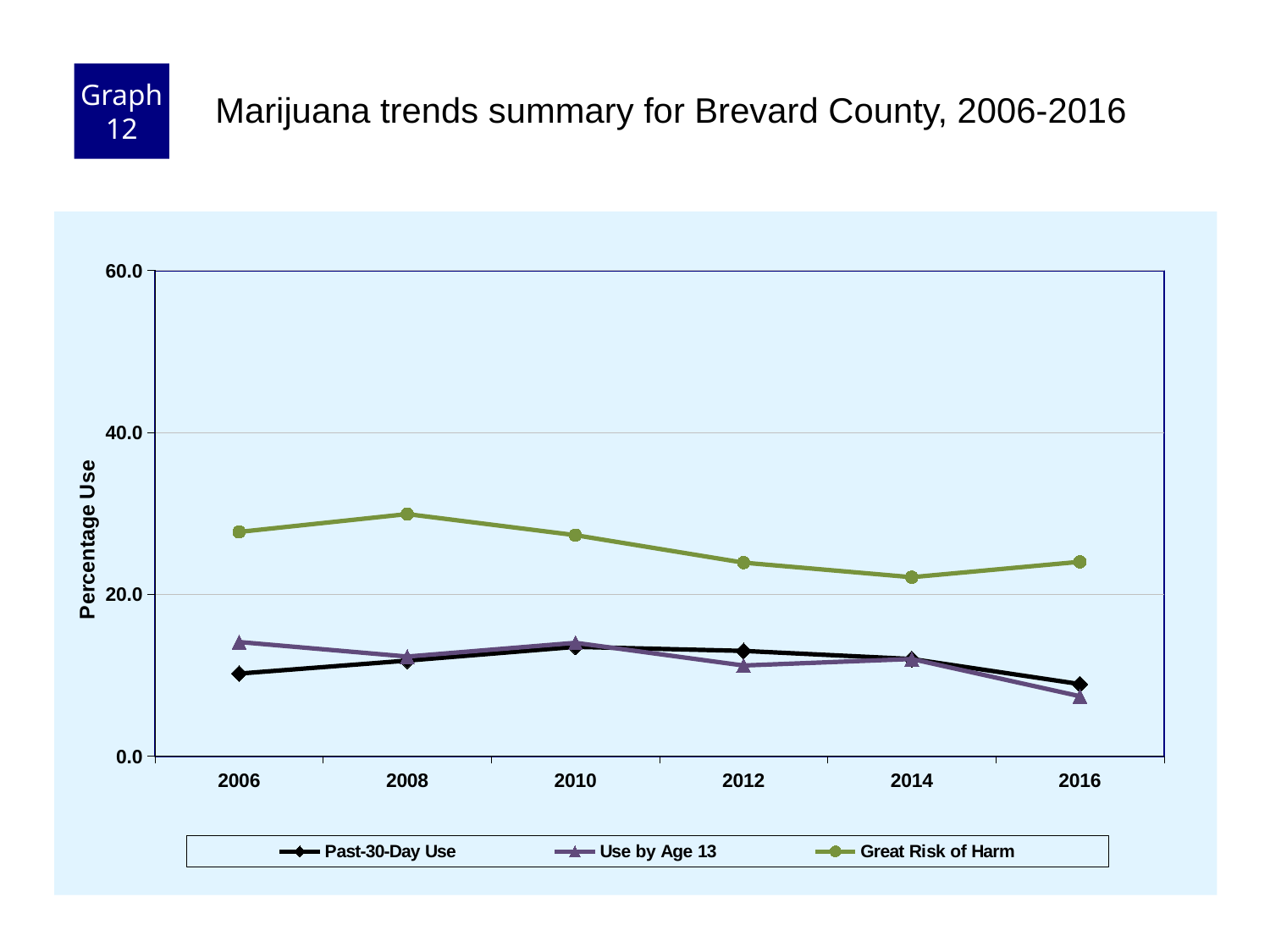
In which year does the Great Risk of Harm series reach its lowest value? 2014 How many years are plotted along the x axis? 6 Which series is plotted with the highest values across all years? Great Risk of Harm Is the value for Great Risk of Harm in 2008 greater or less than 20.0? greater What is the label on the y axis? Percentage Use How many series does the legend list? 3 What kind of chart is shown on the slide? Line chart In which year is the Use by Age 13 series at its lowest? 2016 Does the Great Risk of Harm series rise or fall between 2008 and 2014? Fall Is the value for Past-30-Day Use in 2006 greater or less than 20.0? less In which year does the Great Risk of Harm series reach its highest value? 2008 In 2006, which is higher: Use by Age 13 or Past-30-Day Use? Use by Age 13